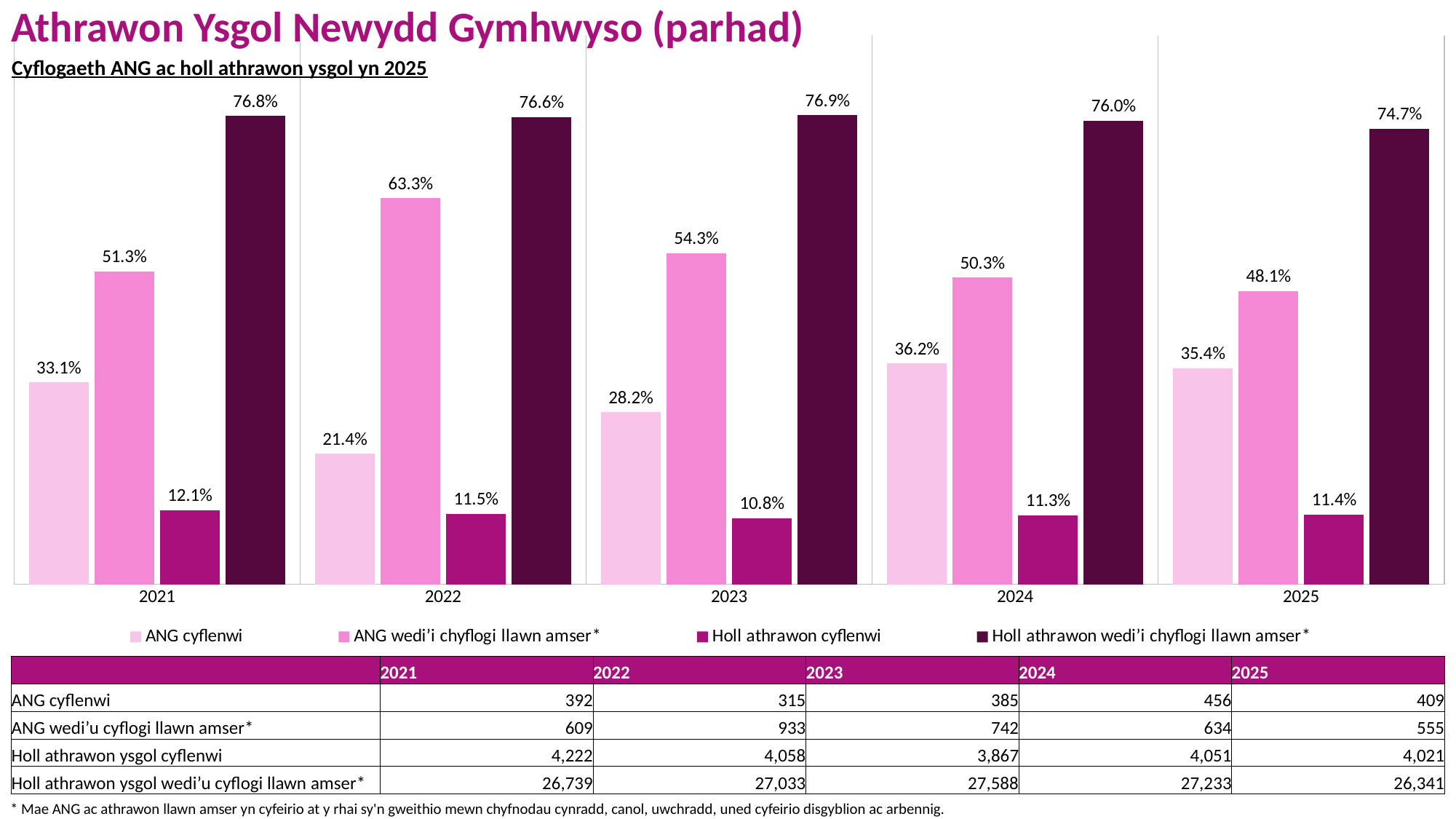
What kind of chart is shown on the slide? Bar chart How many years are shown on the x axis of the chart? 5 What is the value for Holl athrawon wedi'i chyflogi llawn amser in 2025? 74.7% What is the value for Holl athrawon cyflenwi in 2024? 11.3% Does the value for Holl athrawon wedi'i chyflogi llawn amser rise or fall from 2023 to 2025? Fall In which year is the value for ANG wedi'i chyflogi llawn amser the highest? 2022 What is the value for ANG cyflenwi in 2022? 21.4% In which year is the value for Holl athrawon cyflenwi the lowest? 2023 What is the title of the chart? Cyflogaeth ANG ac holl athrawon ysgol yn 2025 In 2021, what is the difference between ANG wedi'i chyflogi llawn amser and ANG cyflenwi? 18.2 percentage points Which year has the larger value for ANG cyflenwi, 2024 or 2025? 2024 How many series does the chart's legend list? 4